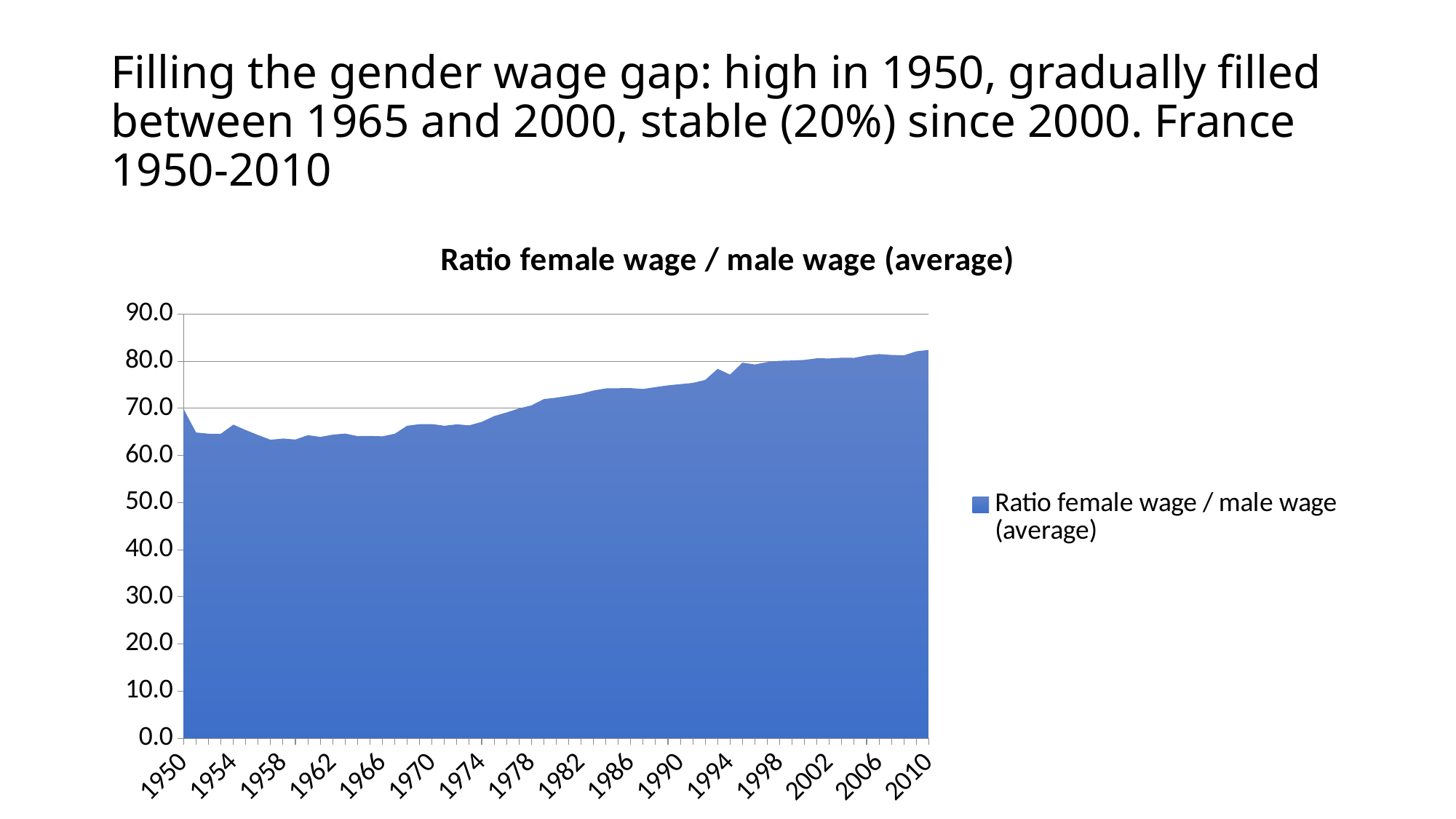
Is the value for 1986 greater or less than 70? greater Which is larger, the value for 1950 or the value for 2010? 2010 Which is larger, the value for 1958 or the value for 1982? 1982 Is the value for 1966 greater or less than 60? greater Is the value for 1990 greater or less than 80? less What is the title of the chart? Ratio female wage / male wage (average) Do the values rise or fall between 1966 and 2010? rise What kind of chart is shown on the slide? Area chart How many series does the legend list? 1 What is the highest value shown on the vertical axis? 90.0